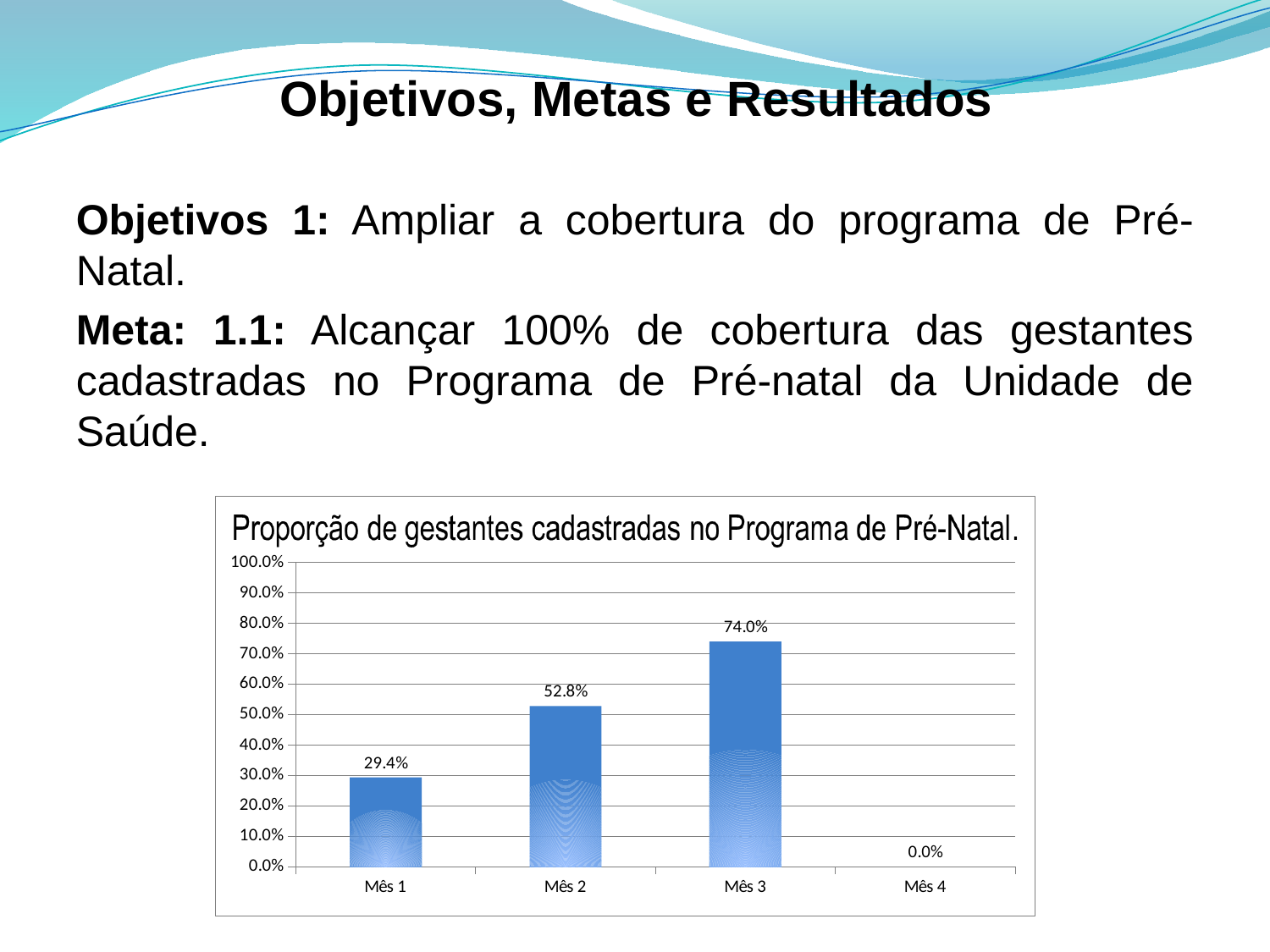
What kind of chart is shown on the slide? Bar chart What is the value for Mês 3? 74.0% What is the title of the chart? Proporção de gestantes cadastradas no Programa de Pré-Natal. Which is larger, the value for Mês 1 or the value for Mês 2? Mês 2 What is the difference between the values for Mês 2 and Mês 1? 23.4% What is the difference between the values for Mês 3 and Mês 2? 21.2% Which month has the highest value? Mês 3 Which month has the lowest value? Mês 4 What is the value for Mês 4? 0.0% How many months are shown on the x axis? 4 What is the value for Mês 2? 52.8% What is the value for Mês 1? 29.4%